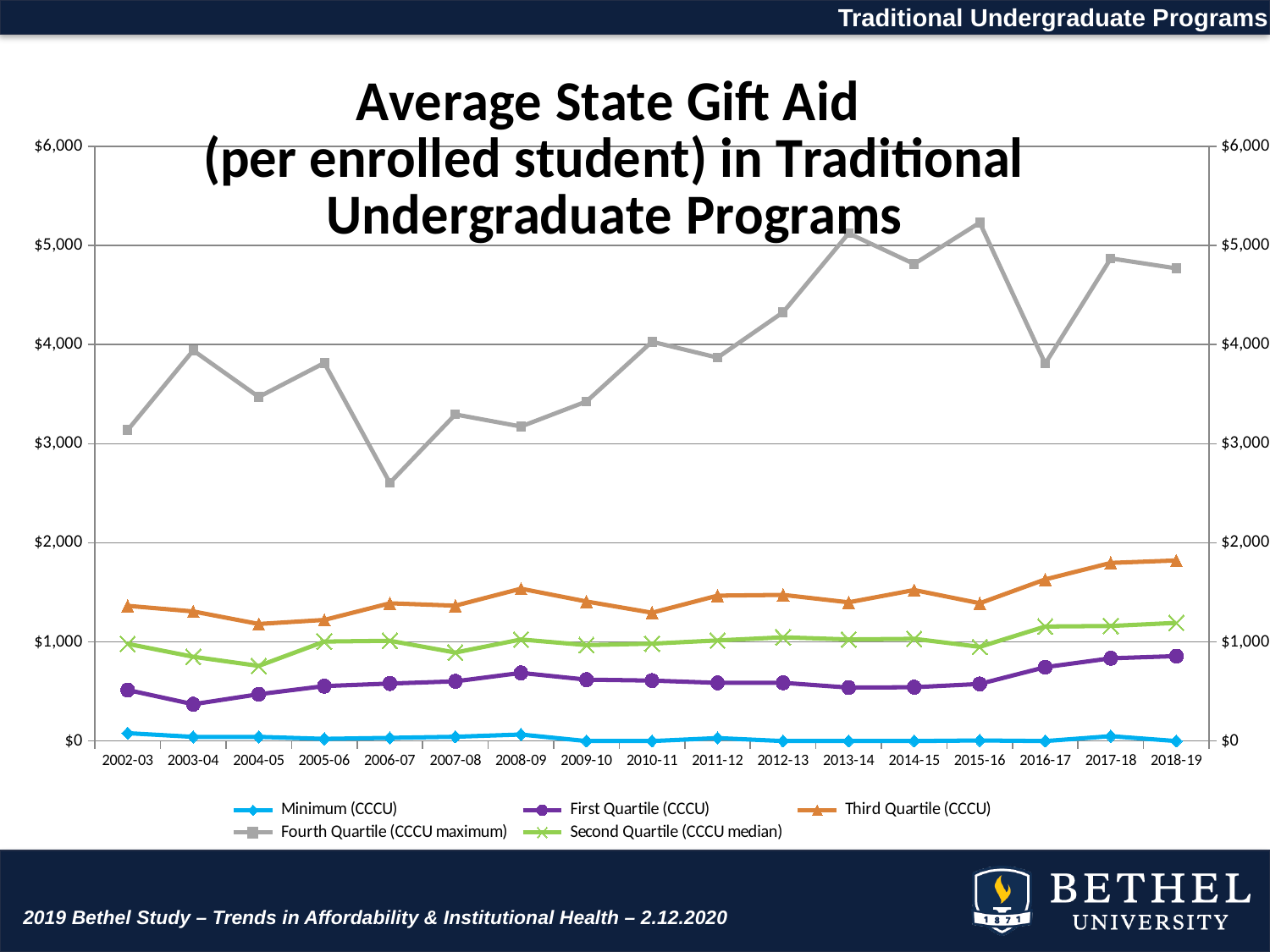
In which year is the Fourth Quartile (CCCU maximum) value lowest? 2006-07 How many series does the legend list? 5 Is the Third Quartile (CCCU) value for 2018-19 greater or less than $1,000? greater Does the Third Quartile (CCCU) series rise or fall from 2015-16 to 2018-19? rise How many academic years are plotted along the x axis? 17 What kind of chart is shown on the slide? line chart Is the Fourth Quartile (CCCU maximum) value for 2018-19 greater or less than $4,000? greater Which series is drawn in grey with square markers? Fourth Quartile (CCCU maximum) Which is larger for the Third Quartile (CCCU): the value for 2002-03 or the value for 2018-19? 2018-19 Is the Fourth Quartile (CCCU maximum) value for 2006-07 greater or less than $3,000? less Which is larger for the Fourth Quartile (CCCU maximum): the value for 2016-17 or the value for 2017-18? 2017-18